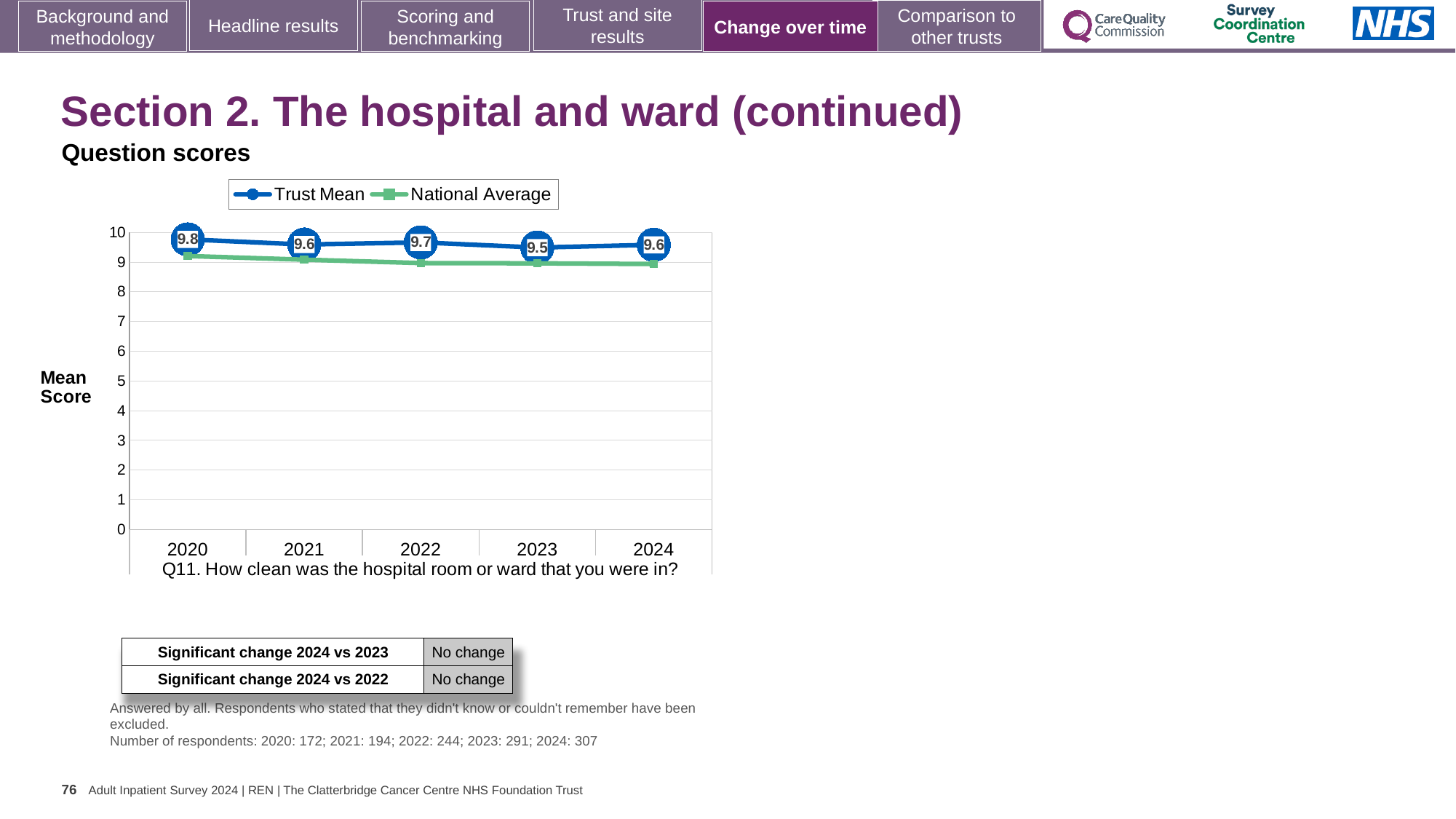
How many years are shown on the x axis? 5 What kind of chart is shown on the slide? Line chart Which is larger, the Trust Mean in 2022 or in 2024? 2022 What is the difference between the Trust Mean in 2020 and in 2023? 0.3 Is the National Average value for 2024 greater or less than 8? greater In which year is the Trust Mean highest? 2020 What is the Trust Mean value for 2024? 9.6 How many series does the legend list? 2 Which question does the chart show scores for? Q11. How clean was the hospital room or ward that you were in? What is the Trust Mean value for 2020? 9.8 What is the Trust Mean value for 2023? 9.5 In which year is the Trust Mean lowest? 2023